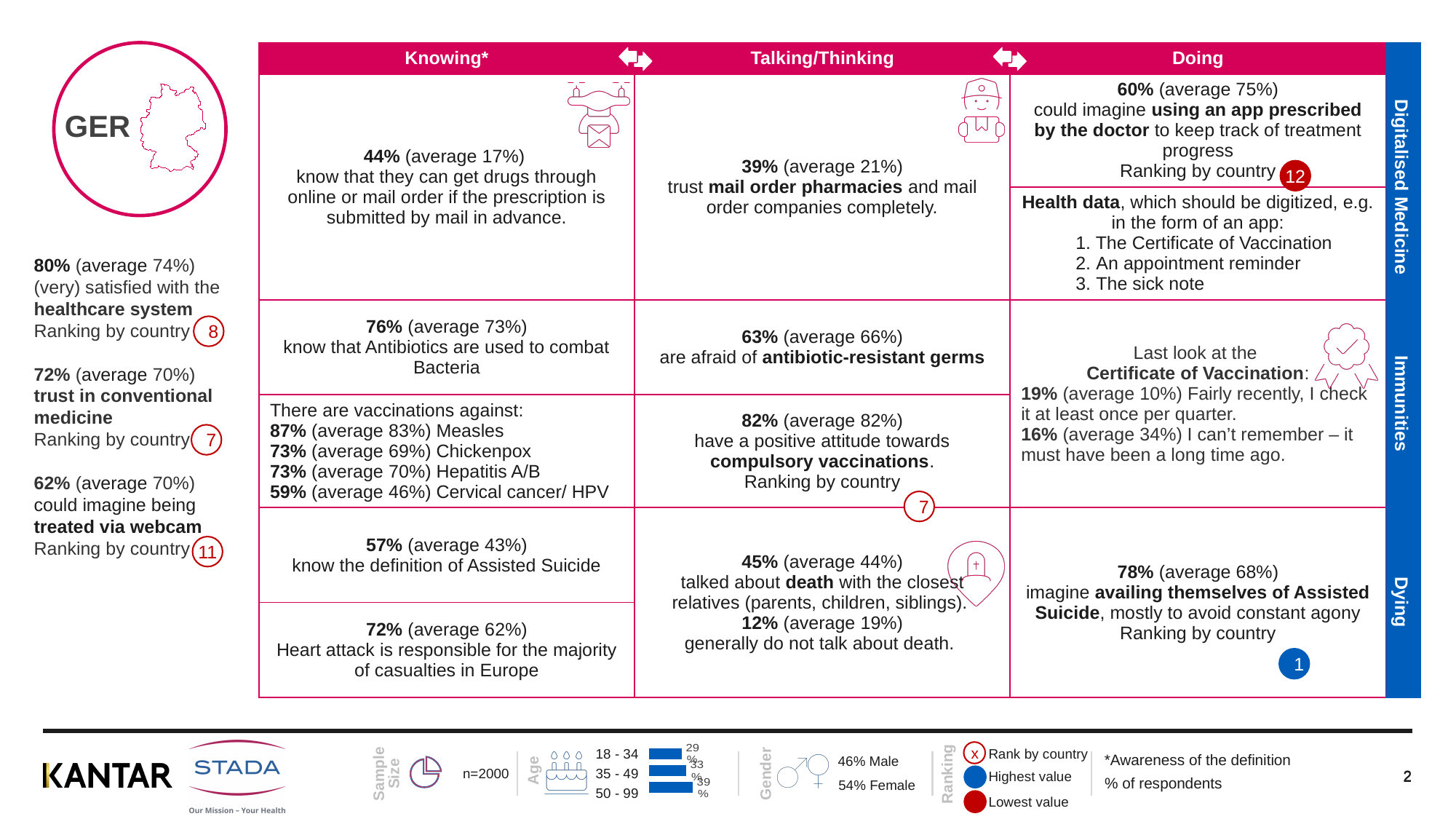
What does the small bar chart at the bottom of the slide show? Age distribution of respondents In the Age bar chart at the bottom of the slide, what is the value for the 35 - 49 age group? 33% How many age groups are shown in the Age bar chart at the bottom of the slide? 3 In the Age bar chart at the bottom of the slide, which age group has the lowest value? 18 - 34 What kind of chart is the Age chart at the bottom of the slide? bar chart In the Age bar chart at the bottom of the slide, what is the value for the 50 - 99 age group? 39% In the Age bar chart at the bottom of the slide, what is the difference between the 50 - 99 and 18 - 34 age groups? 10 percentage points In the Age bar chart at the bottom of the slide, what is the value for the 18 - 34 age group? 29% In the Age bar chart at the bottom of the slide, which age group has the highest value? 50 - 99 In the Age bar chart at the bottom of the slide, what is the difference between the 35 - 49 and 18 - 34 age groups? 4 percentage points In the Age bar chart at the bottom of the slide, which is larger: the value for 35 - 49 or for 50 - 99? 50 - 99 In the Age bar chart at the bottom of the slide, do the values rise or fall from the youngest to the oldest age group? rise